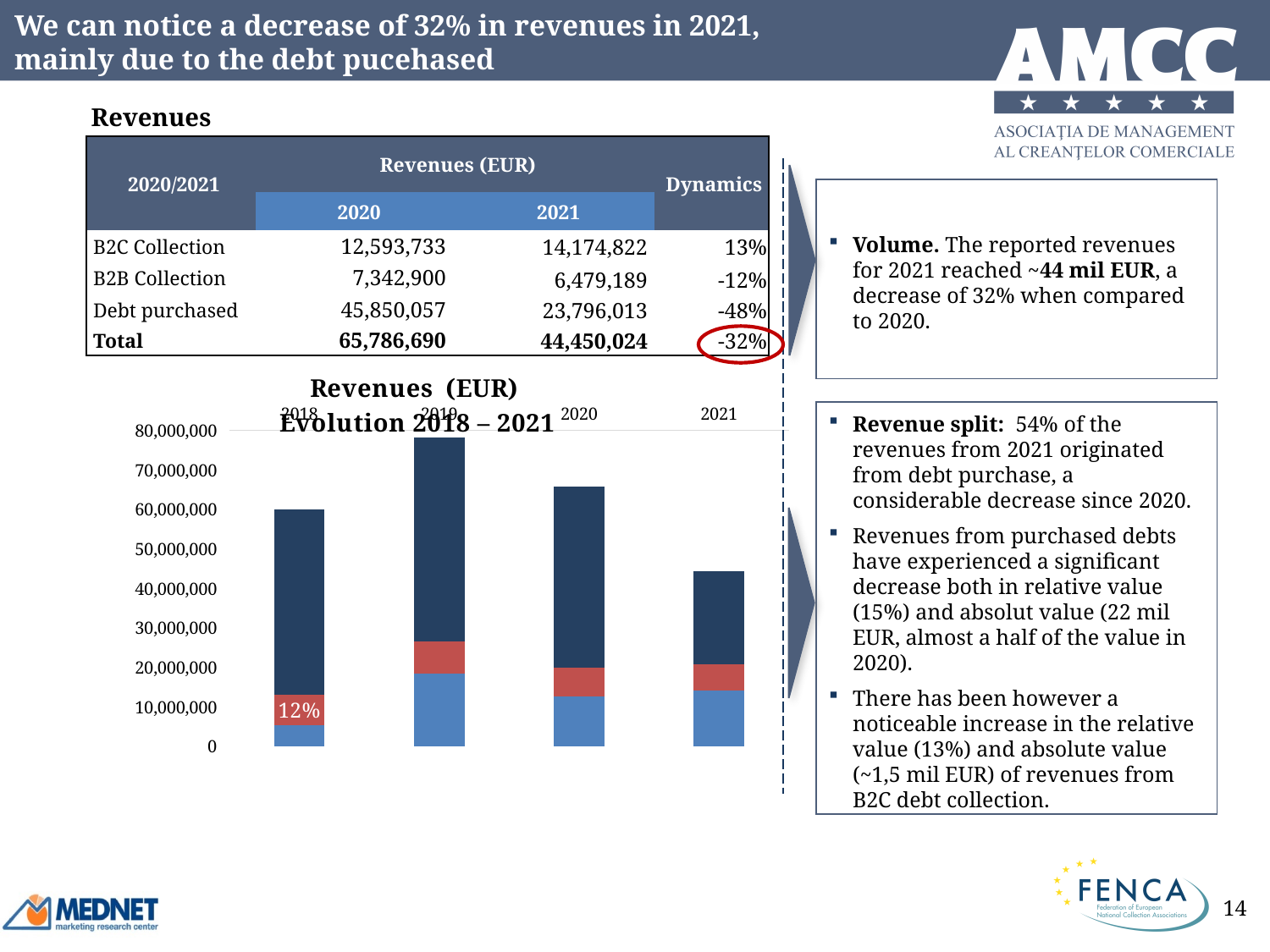
How many years are shown on the x axis of the "Revenues (EUR) Evolution 2018 – 2021" chart? 4 In the "Revenues (EUR) Evolution 2018 – 2021" chart, do the total bars rise or fall from 2019 to 2021? fall What is the title of the bar chart on the slide? Revenues (EUR) Evolution 2018 – 2021 In the "Revenues (EUR) Evolution 2018 – 2021" chart, which year has the taller total bar, 2018 or 2020? 2020 In the "Revenues (EUR) Evolution 2018 – 2021" chart, which year has the shortest stacked bar? 2021 In the "Revenues (EUR) Evolution 2018 – 2021" chart, is the total bar for 2021 greater or less than 50,000,000? less How many coloured segments make up each stacked bar in the "Revenues (EUR) Evolution 2018 – 2021" chart? 3 In the "Revenues (EUR) Evolution 2018 – 2021" chart, is the total bar for 2018 greater or less than 70,000,000? less What percentage label is printed on the 2018 bar in the "Revenues (EUR) Evolution 2018 – 2021" chart? 12% What kind of chart is the "Revenues (EUR) Evolution 2018 – 2021" chart? bar chart In the "Revenues (EUR) Evolution 2018 – 2021" chart, which year has the tallest stacked bar? 2019 In the "Revenues (EUR) Evolution 2018 – 2021" chart, is the total bar for 2019 greater or less than 70,000,000? greater